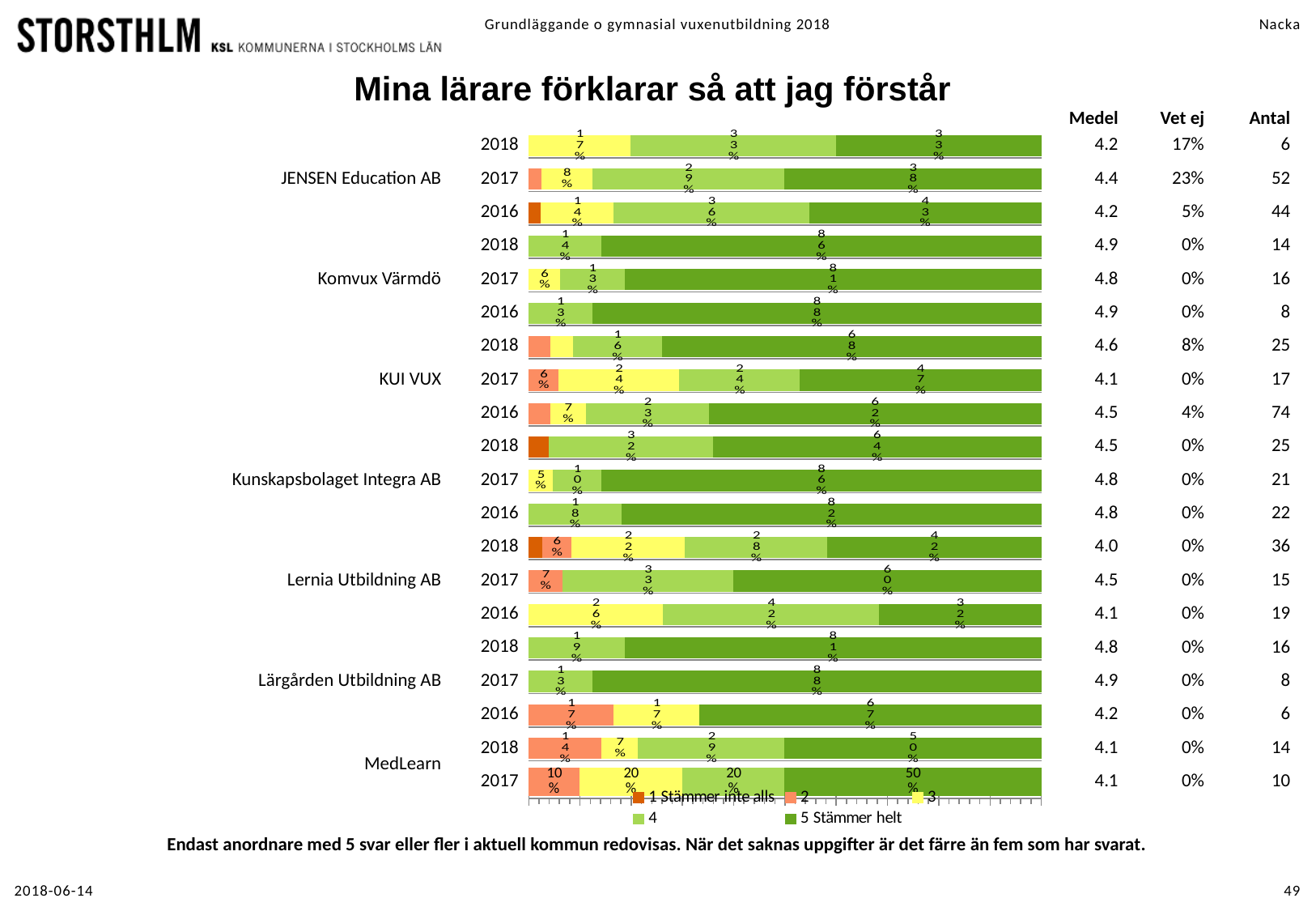
What percentage of Komvux Värmdö respondents in 2018 answered '5 Stämmer helt'? 86% What percentage of Lärgården Utbildning AB respondents in 2016 answered '5 Stämmer helt'? 67% How many series does the legend list? 5 What kind of chart is shown on the slide? bar chart What is the title of the chart? Mina lärare förklarar så att jag förstår For Lernia Utbildning AB, which year had the larger share of '5 Stämmer helt' answers, 2017 or 2016? 2017 What percentage of Kunskapsbolaget Integra AB respondents in 2016 answered '4'? 18% What percentage of Lernia Utbildning AB respondents in 2016 answered '3'? 26% For Komvux Värmdö in 2018, what is the difference in percentage points between the '5 Stämmer helt' share and the '4' share? 72 What percentage of KUI VUX respondents in 2017 answered '5 Stämmer helt'? 47% For Lärgården Utbildning AB, which year had the highest share of '5 Stämmer helt' answers? 2017